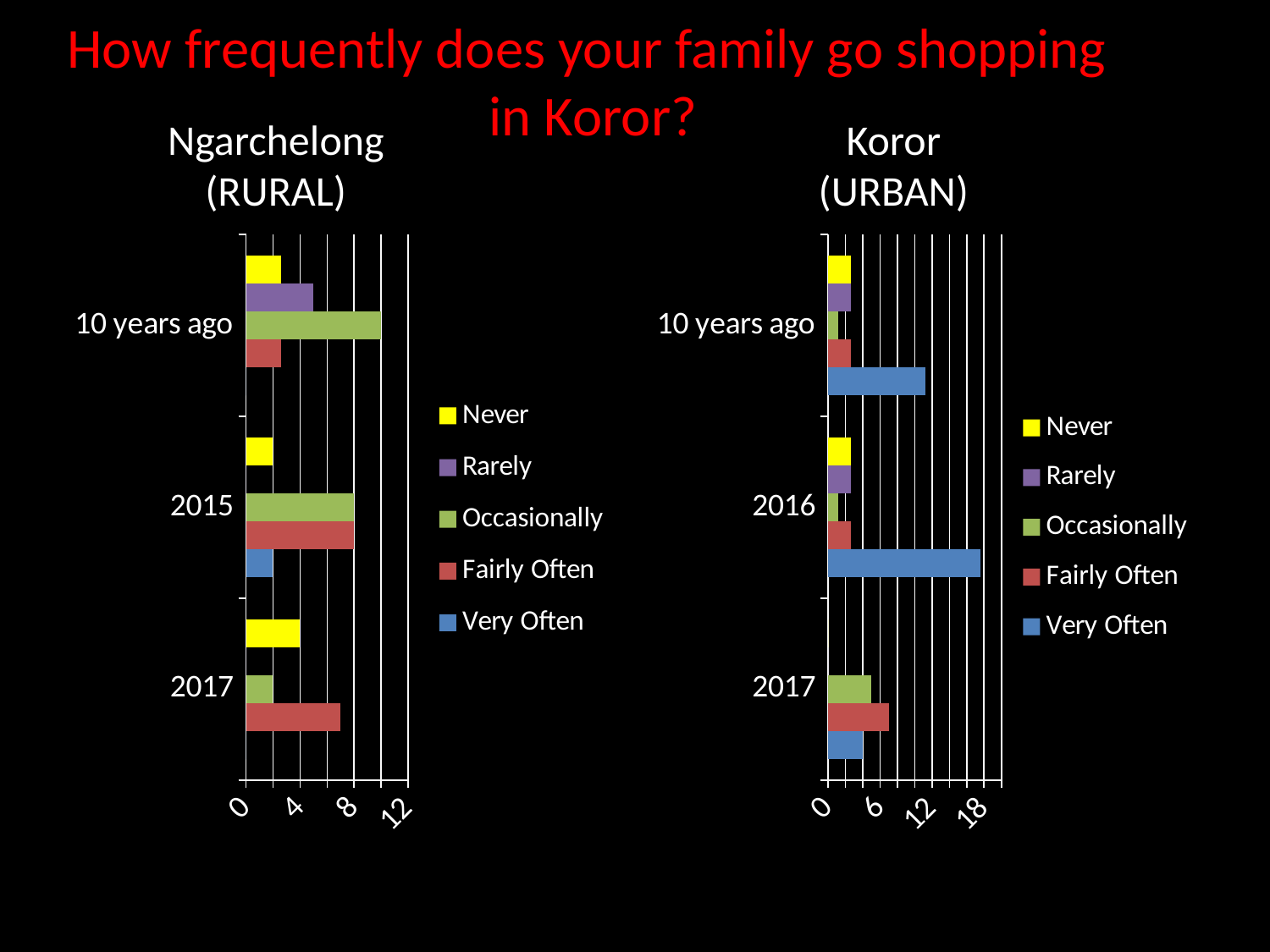
In the Koror (URBAN) chart, is the value for Very Often in 2016 greater or less than 12? greater In the Ngarchelong (RURAL) chart, for 2017, which is larger: Fairly Often or Occasionally? Fairly Often In the Ngarchelong (RURAL) chart, is the value for Occasionally 10 years ago greater or less than 8? greater How many series does the legend of the Koror (URBAN) chart list? 5 In the Koror (URBAN) chart, which series has the longest bar for 2016? Very Often In the Koror (URBAN) chart, is the Very Often bar larger for 10 years ago or for 2016? 2016 In the Ngarchelong (RURAL) chart, is the value for Fairly Often in 2017 greater or less than 4? greater How many categories are shown on the y axis of the Ngarchelong (RURAL) chart? 3 In the Ngarchelong (RURAL) chart, which series has the longest bar for 10 years ago? Occasionally What is the middle category label on the y axis of the Koror (URBAN) chart? 2016 What kind of chart is the Ngarchelong (RURAL) chart? bar chart